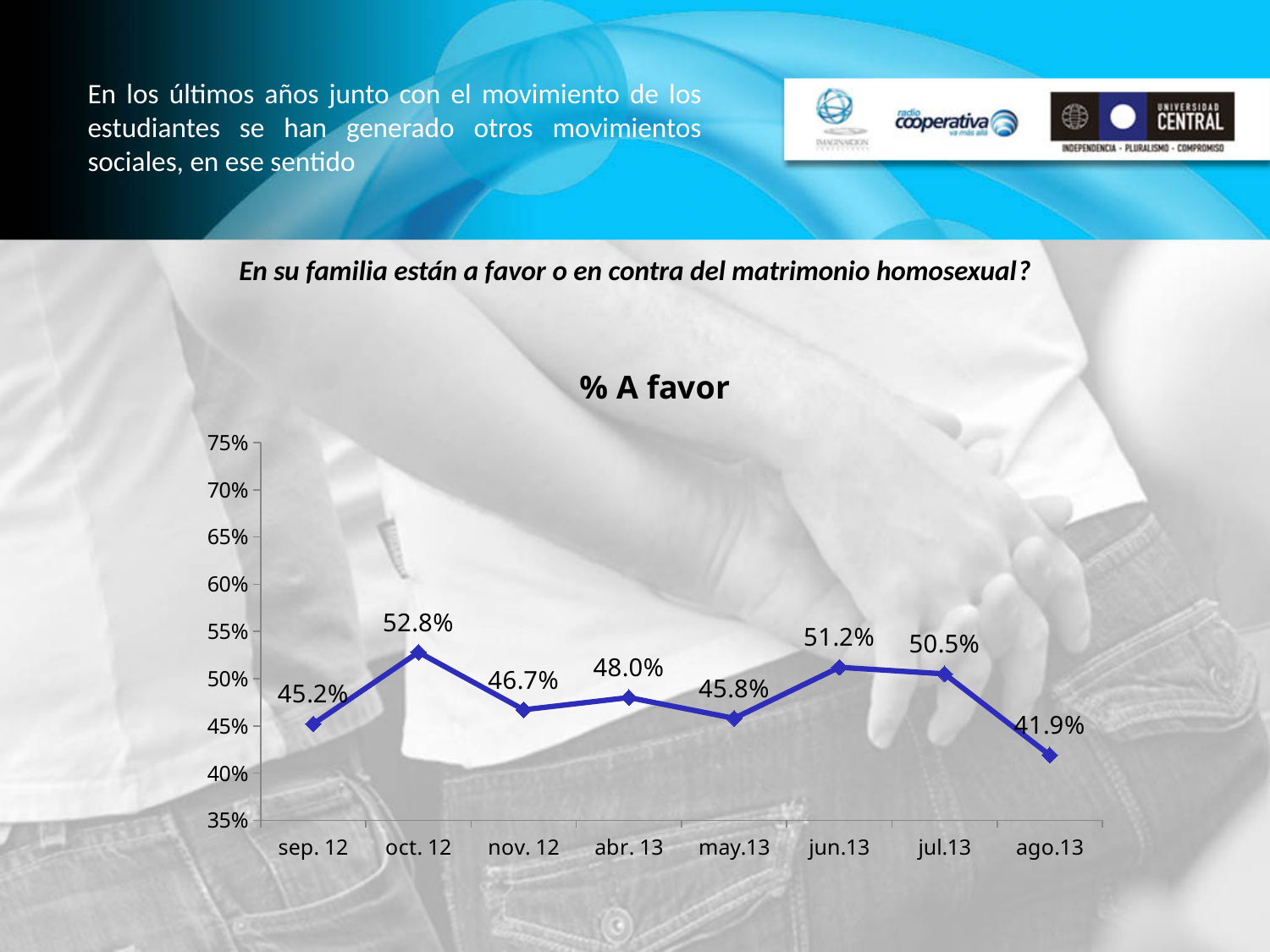
Which month has the highest value? oct. 12 How many data points are plotted on the chart? 8 Do the values rise or fall from jul.13 to ago.13? fall What is the title of the chart? % A favor What is the value for ago.13? 41.9% What is the difference between the values for jun.13 and may.13? 5.4% What kind of chart is shown? line chart Is the value for jul.13 greater or less than 45%? greater Which month has the lowest value? ago.13 What is the value for abr. 13? 48.0% Which is larger, the value for sep. 12 or the value for nov. 12? nov. 12 What is the value for oct. 12? 52.8%